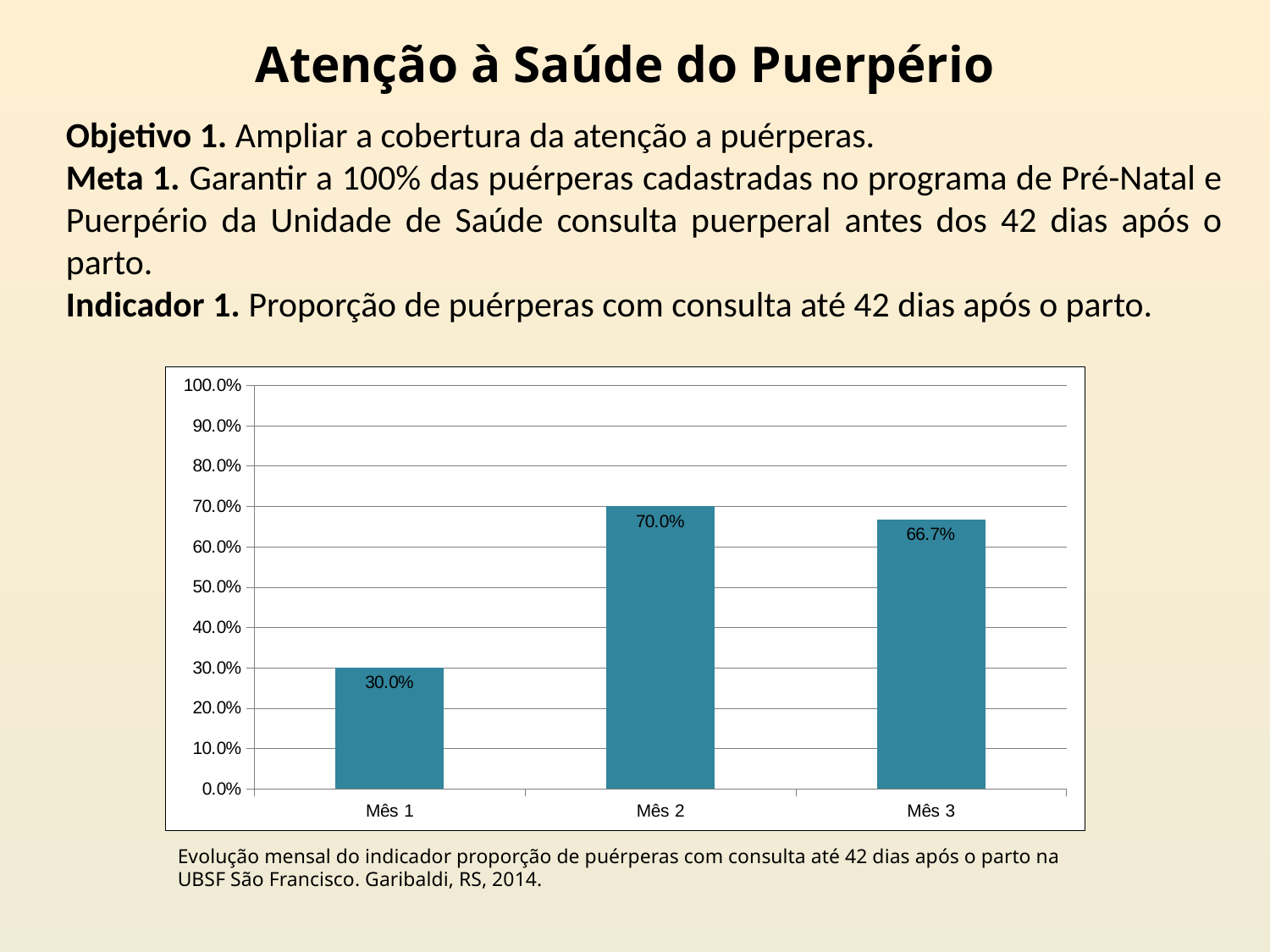
What is the value for Mês 2? 70.0% Which month has the highest value? Mês 2 What kind of chart is shown on the slide? bar chart What is the value for Mês 1? 30.0% What is the highest value shown on the y axis? 100.0% Which month has the lowest value? Mês 1 Is the value for Mês 3 greater or less than 60.0%? greater What is the difference between the values for Mês 2 and Mês 3? 3.3% What is the difference between the values for Mês 2 and Mês 1? 40.0% What is the value for Mês 3? 66.7% Which is larger, the value for Mês 1 or the value for Mês 3? Mês 3 How many months are shown on the x axis? 3